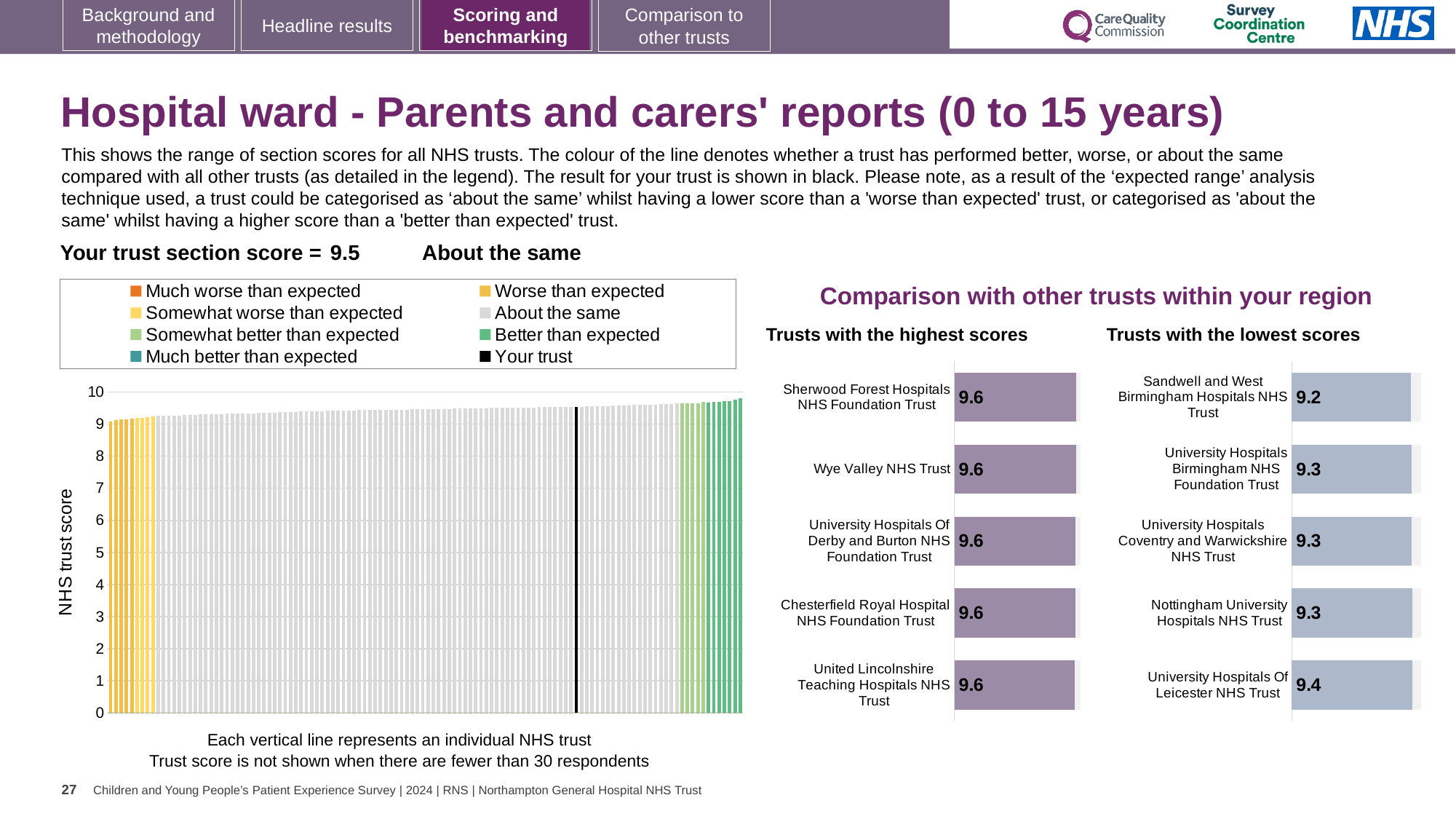
In the 'Trusts with the lowest scores' chart, which trust has the highest score? University Hospitals Of Leicester NHS Trust How many trusts are shown in the 'Trusts with the lowest scores' chart? 5 In the 'Trusts with the highest scores' chart, what is the score for Wye Valley NHS Trust? 9.6 How many trusts are shown in the 'Trusts with the highest scores' chart? 5 In the large chart on the left, is the value for the black 'Your trust' bar greater or less than 9? greater In the 'Trusts with the lowest scores' chart, which trust has the lowest score? Sandwell and West Birmingham Hospitals NHS Trust In the 'Trusts with the lowest scores' chart, what is the difference between the scores of University Hospitals Of Leicester NHS Trust and Sandwell and West Birmingham Hospitals NHS Trust? 0.2 What kind of chart is the large chart on the left with the 'NHS trust score' axis? Bar chart In the 'Trusts with the lowest scores' chart, what is the score for Sandwell and West Birmingham Hospitals NHS Trust? 9.2 In the 'Trusts with the lowest scores' chart, which has the larger score: Nottingham University Hospitals NHS Trust or Sandwell and West Birmingham Hospitals NHS Trust? Nottingham University Hospitals NHS Trust How many entries does the legend above the large chart on the left list? 8 In the large chart on the left, do the bar values rise or fall from left to right along the x axis? Rise